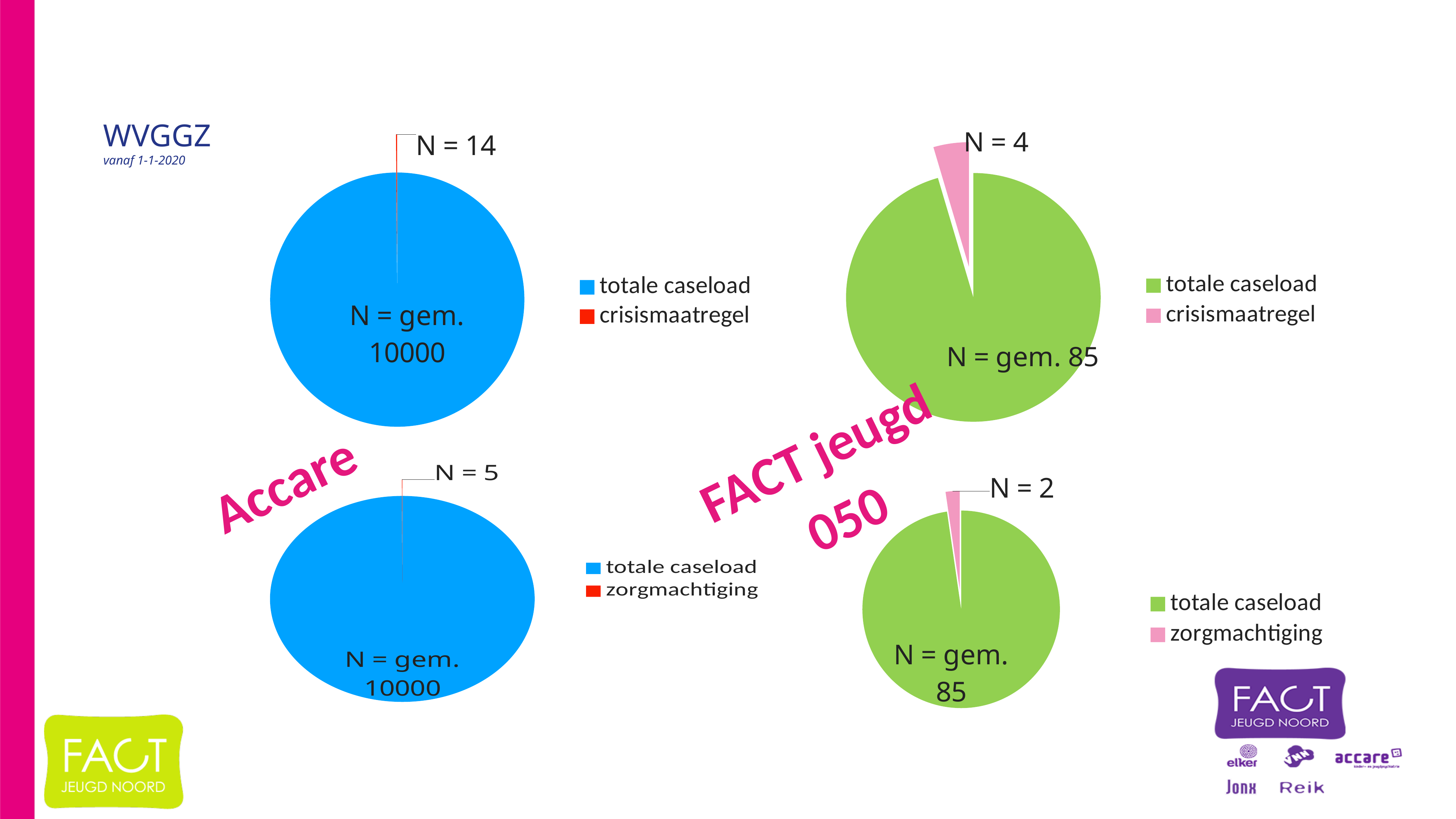
What kind of chart is used for the four charts on this slide? Pie chart In the bottom-left pie chart, what colour is the totale caseload slice? Blue Which is larger: the crisismaatregel value in the top-left pie chart (N = 14) or the crisismaatregel value in the top-right pie chart (N = 4)? Top-left (N = 14) How many entries does the legend of the top-right pie chart list? 2 In the top-left pie chart, what is the label shown on the totale caseload slice? N = gem. 10000 In the top-left pie chart, which slice is larger: totale caseload or crisismaatregel? totale caseload What is the difference between the crisismaatregel value in the top-left pie chart and the zorgmachtiging value in the bottom-left pie chart? 9 In the top-right pie chart, what is the label shown on the totale caseload slice? N = gem. 85 In the bottom-right pie chart, what is the value labelled for the zorgmachtiging slice? N = 2 In the bottom-left pie chart, what is the value labelled for the zorgmachtiging slice? N = 5 In the top-left pie chart, what is the value labelled for the crisismaatregel slice? N = 14 In the top-right pie chart, what is the value labelled for the crisismaatregel slice? N = 4